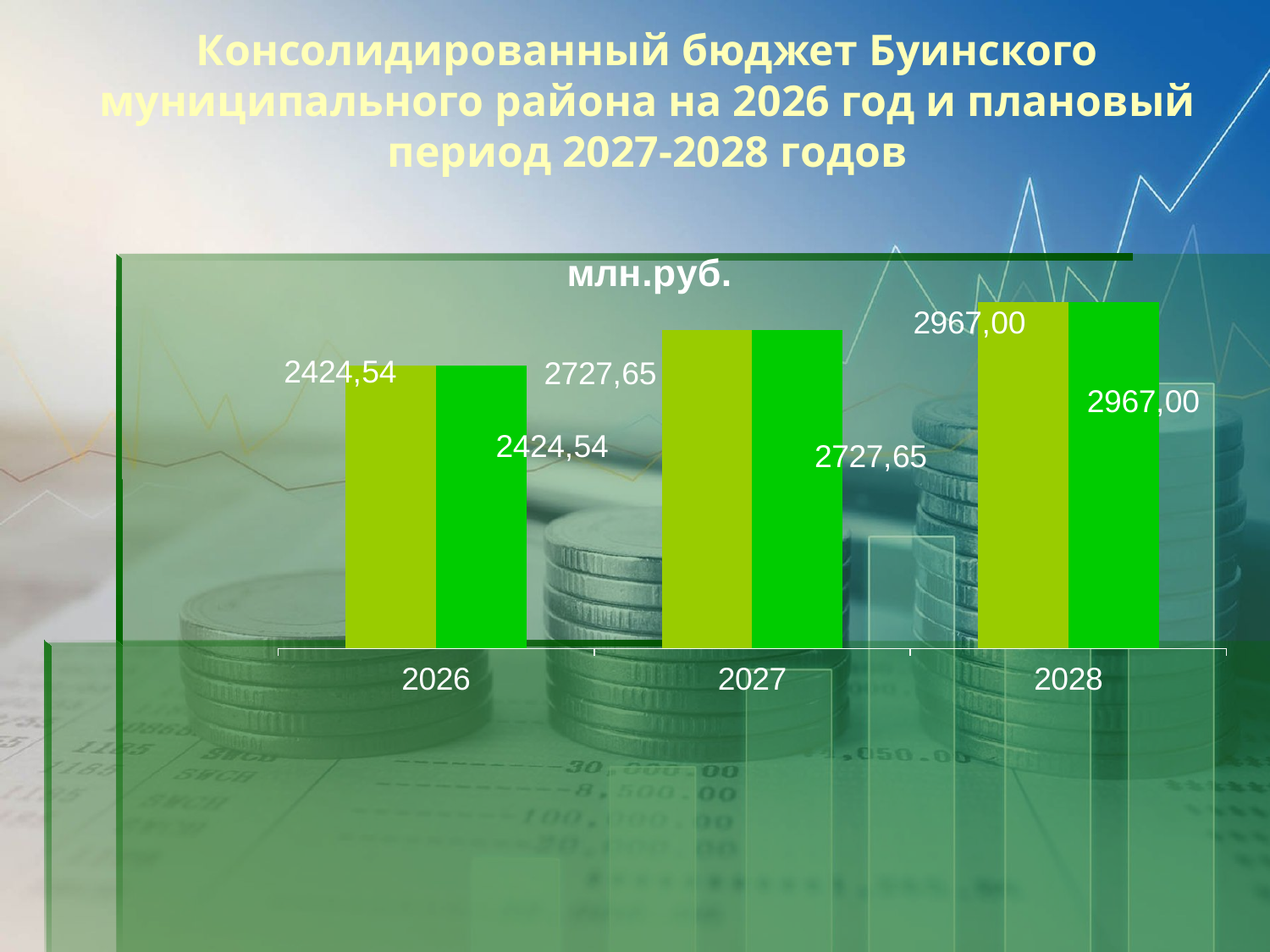
Do the values rise or fall from 2026 to 2028? rise Which year has the highest value? 2028 What is the value shown for 2026? 2424,54 What is the difference between the values for 2027 and 2026? 303,11 What unit is given in the chart title? млн.руб. Which year has the lowest value? 2026 What is the difference between the values for 2028 and 2027? 239,35 How many years are shown on the x axis? 3 What type of chart is shown on the slide? bar chart What is the value shown for 2028? 2967,00 What is the value shown for 2027? 2727,65 Which is larger, the value for 2027 or the value for 2028? 2028